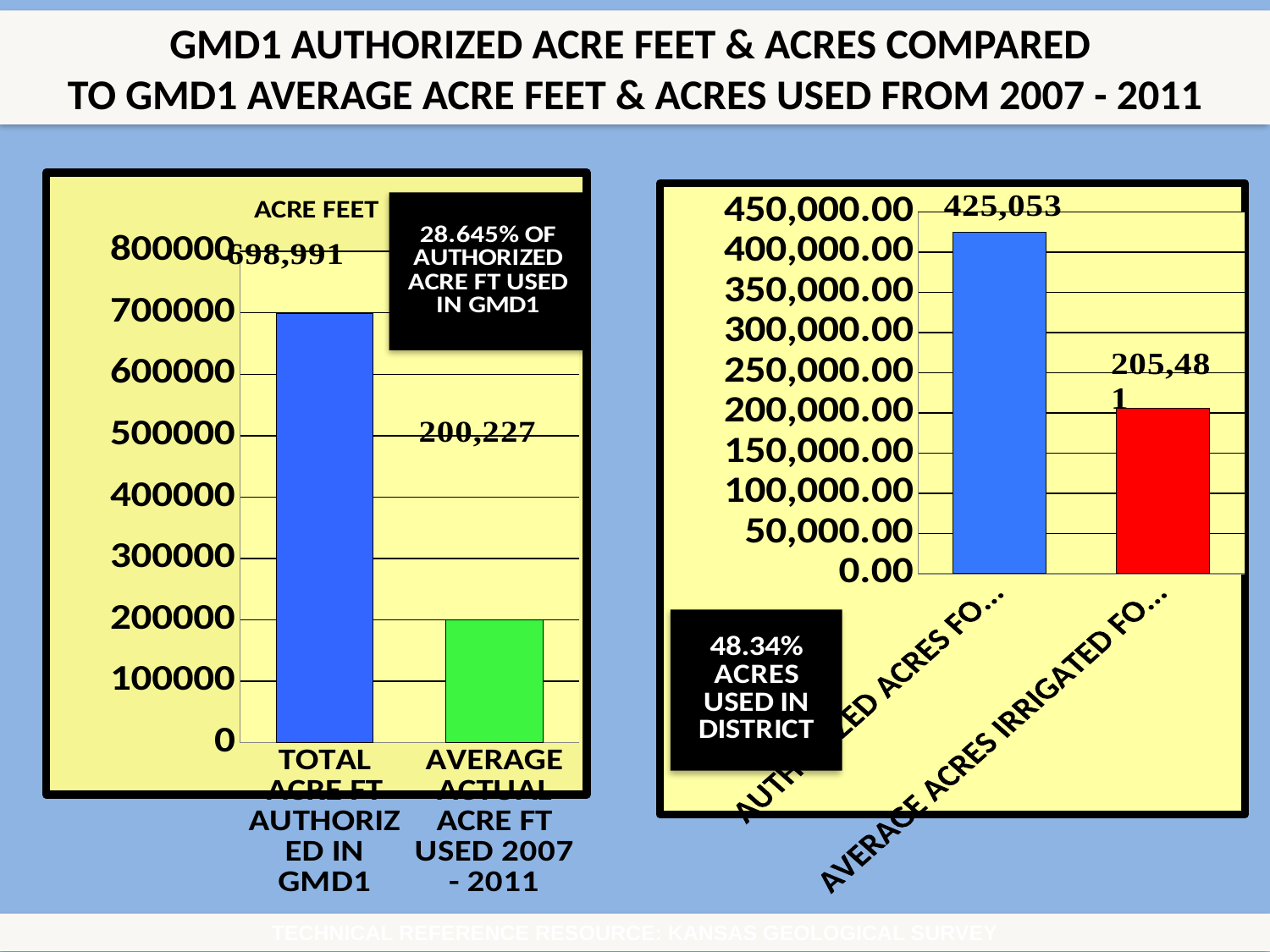
On the left chart titled ACRE FEET, what is the difference between the authorized acre feet and the average actual acre feet used? 498,764 On the left chart titled ACRE FEET, what is the value for TOTAL ACRE FT AUTHORIZED IN GMD1? 698,991 On the right chart, what is the difference between the blue bar and the red bar? 219,572 On the right chart, what is the highest value shown on the vertical axis? 450,000.00 On the right chart, what is the value of the red (right) bar? 205,481 On the right chart, is the value of the red bar greater or less than 250,000.00? less On the left chart titled ACRE FEET, what colour is the bar for AVERAGE ACTUAL ACRE FT USED 2007 - 2011? Green On the left chart titled ACRE FEET, which category has the higher value? TOTAL ACRE FT AUTHORIZED IN GMD1 On the left chart titled ACRE FEET, what is the value for AVERAGE ACTUAL ACRE FT USED 2007 - 2011? 200,227 What type of chart is the left chart titled ACRE FEET? Bar chart On the left chart titled ACRE FEET, how many bars are plotted? 2 On the right chart, what is the value of the blue (left) bar? 425,053